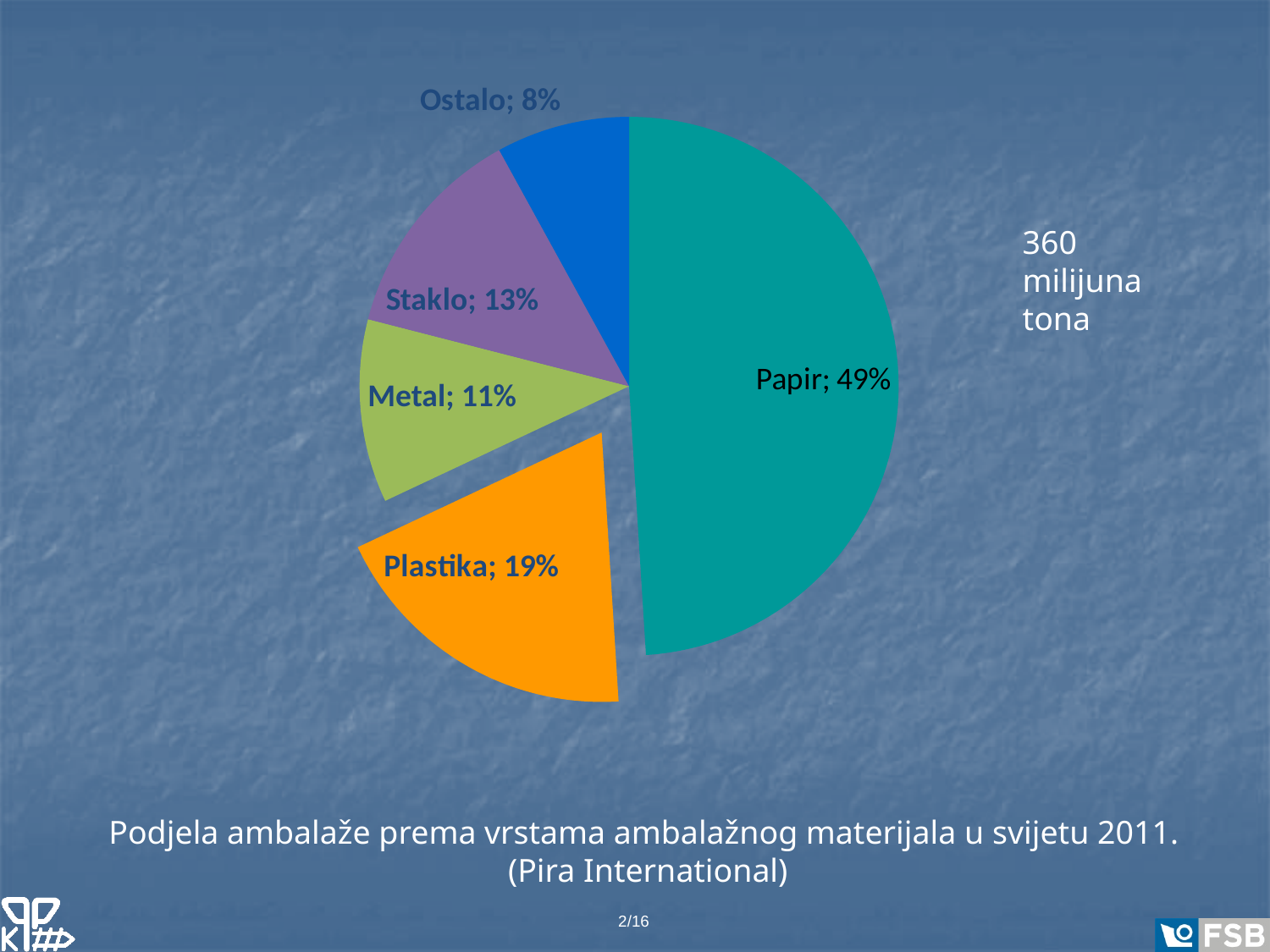
Which category has the smallest slice of the pie? Ostalo What is the value shown for Ostalo? 8% What is the value shown for Plastika? 19% What kind of chart is shown on the slide? Pie chart What is the value shown for Metal? 11% How many categories are shown in the pie chart? 5 Which category has the largest slice of the pie? Papir What is the difference in percentage points between Papir and Plastika? 30 What is the value shown for Staklo? 13% What share of the pie does Papir have? 49% What total quantity is noted next to the pie chart? 360 milijuna tona Which is larger, Staklo or Metal? Staklo